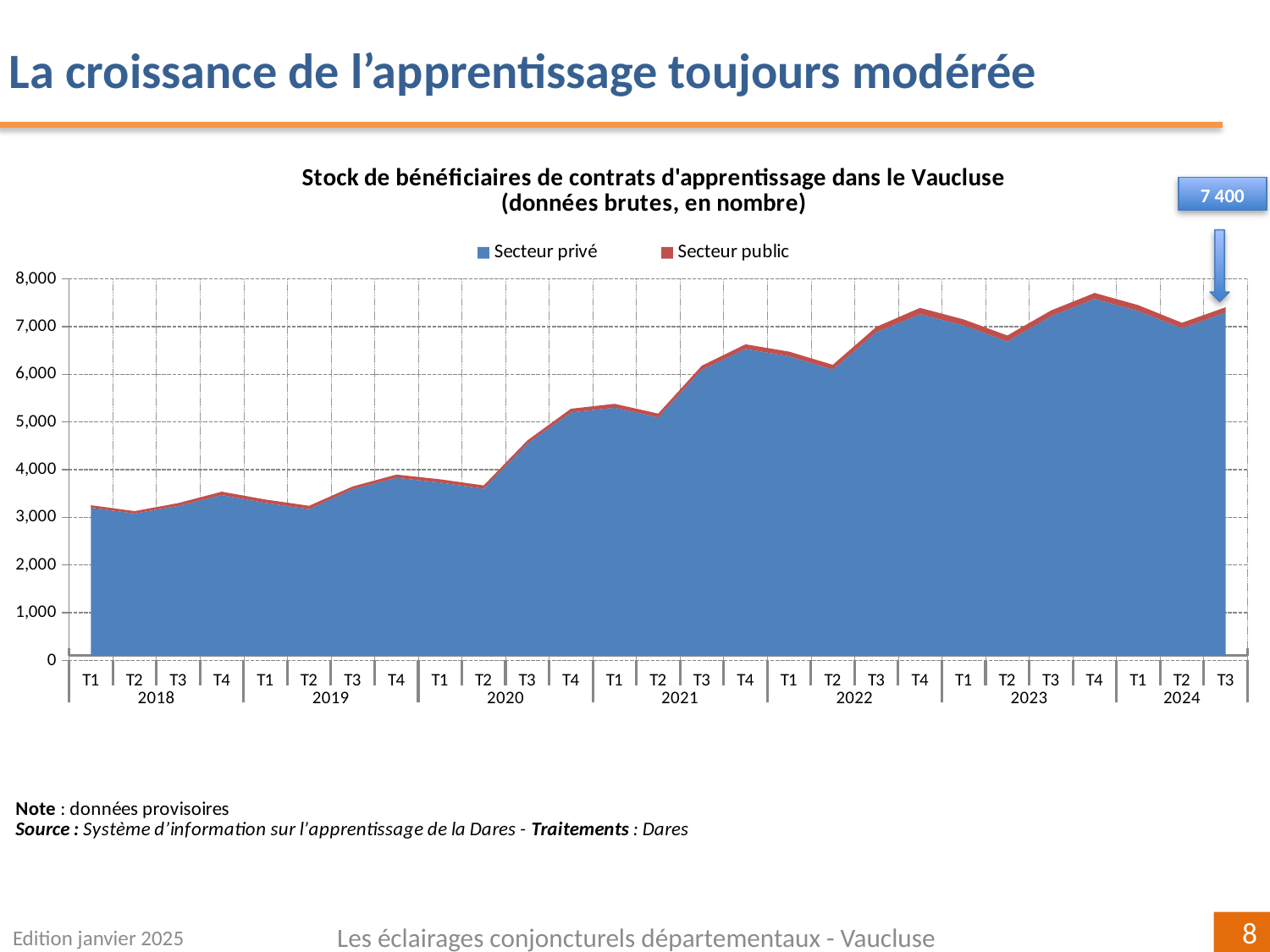
How many series does the legend list? 2 Is the total value for T4 2022 greater or less than 7,000? greater Which is larger, the total for T4 2022 or the total for T4 2020? T4 2022 Is the total value for T4 2021 greater or less than 6,000? greater How many quarterly points are plotted along the x axis? 27 What are the two series named in the legend? Secteur privé, Secteur public Is the total value for T1 2018 greater or less than 4,000? less What kind of chart is shown on the slide? area chart Overall, do the values rise or fall from T1 2018 to T3 2024? rise Which quarter has the highest total stock of apprenticeship beneficiaries? T4 2023 What value is highlighted in the callout for the latest point (T3 2024)? 7 400